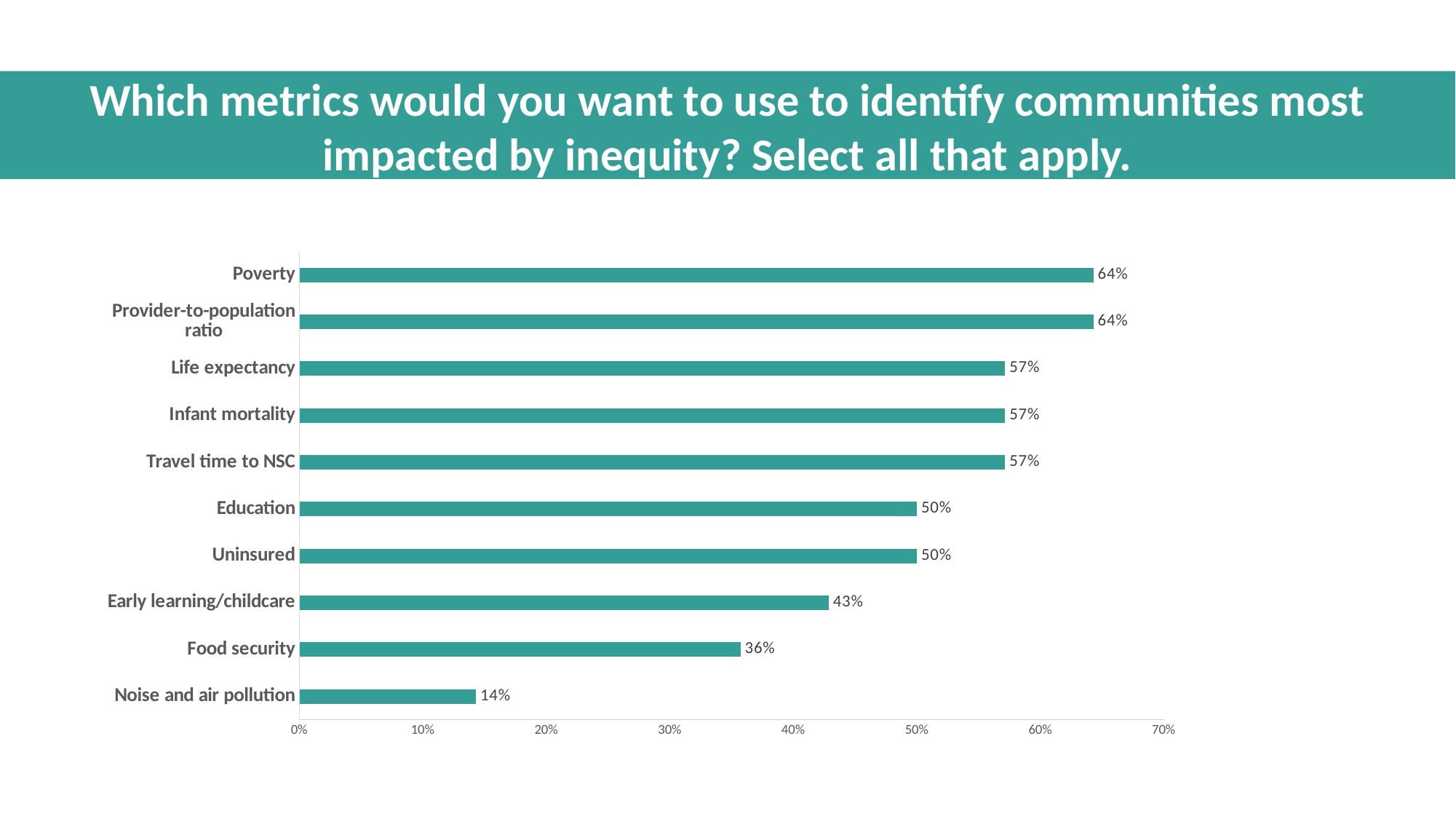
What is the value for Noise and air pollution? 14% Which metric has the lowest value? Noise and air pollution What is the difference between the values for Poverty and Noise and air pollution? 50% What kind of chart is shown on the slide? bar chart What is the difference between the values for Life expectancy and Education? 7% How many metrics are shown in the chart? 10 Is the value for Uninsured greater or less than 40%? greater What is the value for Early learning/childcare? 43% Which is larger, the value for Food security or the value for Early learning/childcare? Early learning/childcare What is the value for Food security? 36% What percentage of respondents selected Poverty? 64% What is the highest value shown on the x axis? 70%